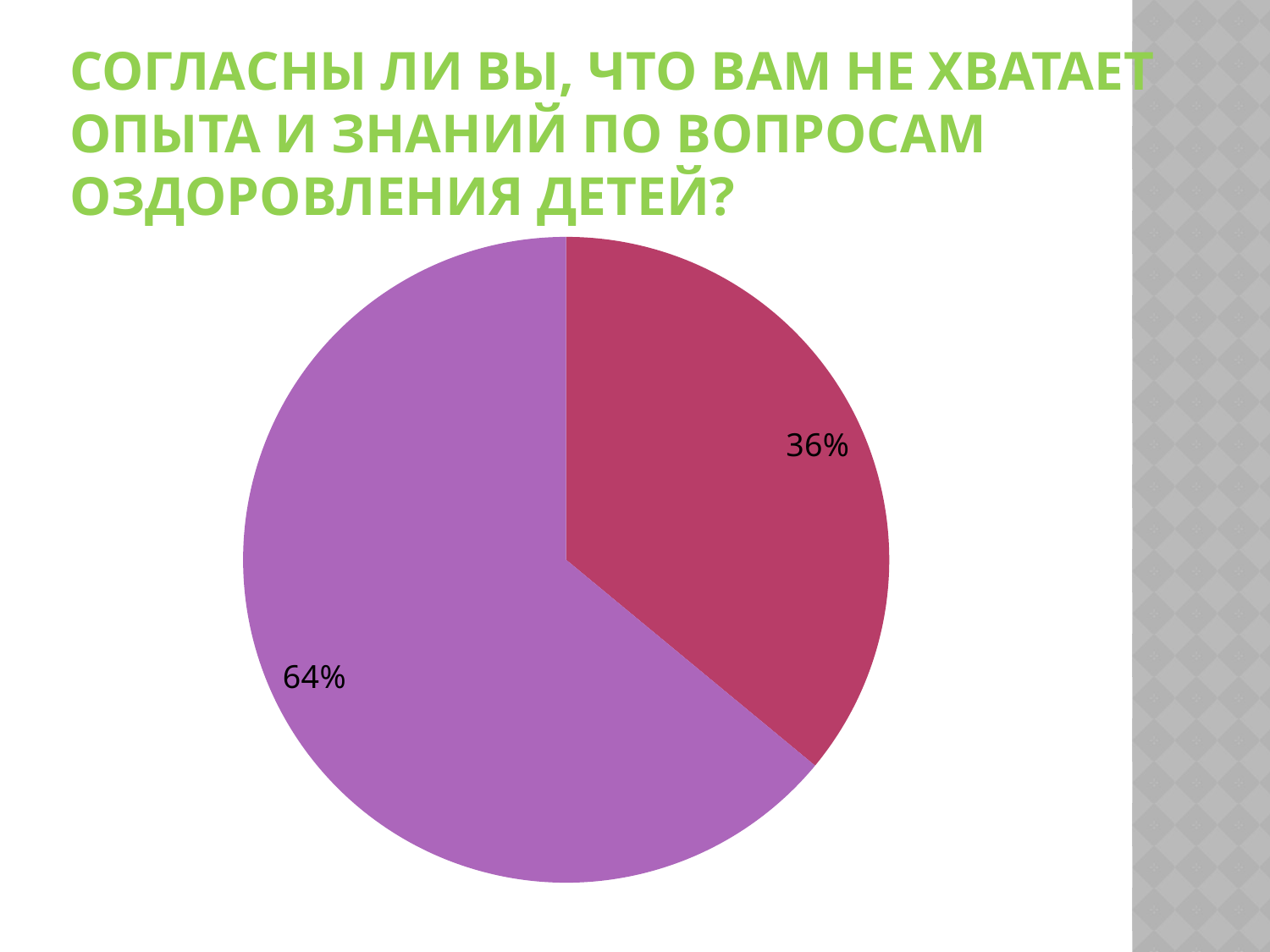
Which slice of the pie chart is the smallest? the red slice (36%) What value is labelled on the purple slice of the pie chart? 64% What is the title of the slide above the pie chart? Согласны ли вы, что вам не хватает опыта и знаний по вопросам оздоровления детей? What share of the pie does the red slice represent? 36% What kind of chart is shown on the slide? pie chart Which slice of the pie chart is the largest? the purple slice (64%) What is the difference between the two slice values shown on the pie chart? 28% What value is labelled on the red slice of the pie chart? 36% Which is larger, the purple slice or the red slice? the purple slice Is the value of the purple slice greater or less than 50%? greater Does the pie chart display a legend? No How many slices does the pie chart have? 2